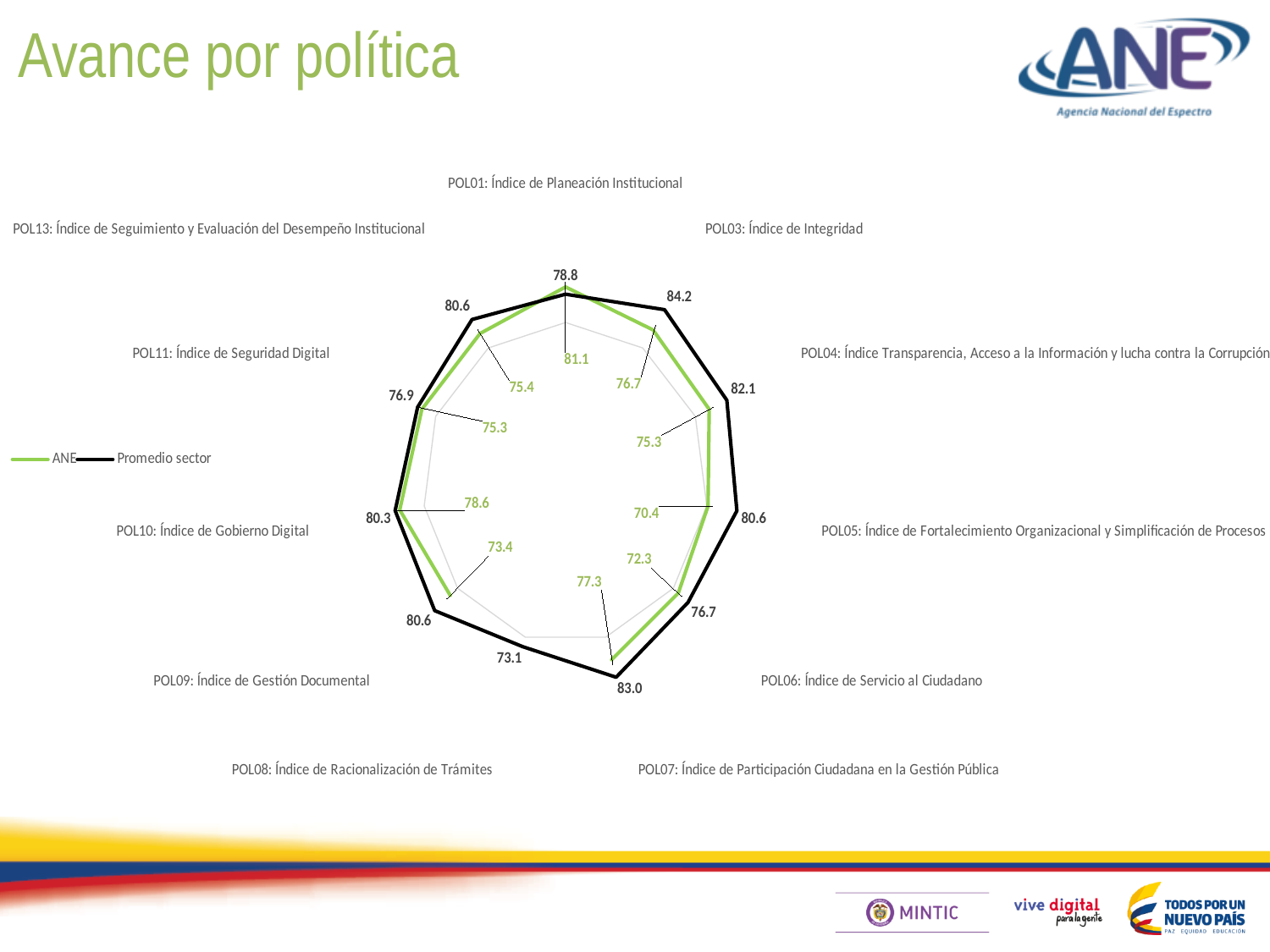
What is the Promedio sector value for POL07: Índice de Participación Ciudadana en la Gestión Pública? 83.0 What is the Promedio sector value for POL03: Índice de Integridad? 84.2 Which policy has the lowest Promedio sector value? POL08: Índice de Racionalización de Trámites How many series does the chart legend list? 2 How many policy categories (axes) does the radar chart have? 11 For POL01: Índice de Planeación Institucional, which is larger, the ANE value or the Promedio sector value? ANE What kind of chart is shown on the slide? Radar chart What is the ANE value for POL05: Índice de Fortalecimiento Organizacional y Simplificación de Procesos? 70.4 Which policy has the highest Promedio sector value? POL03: Índice de Integridad Which policy has the lowest ANE value? POL05: Índice de Fortalecimiento Organizacional y Simplificación de Procesos What is the difference between the Promedio sector and ANE values for POL03: Índice de Integridad? 7.5 What are the two series named in the legend? ANE and Promedio sector